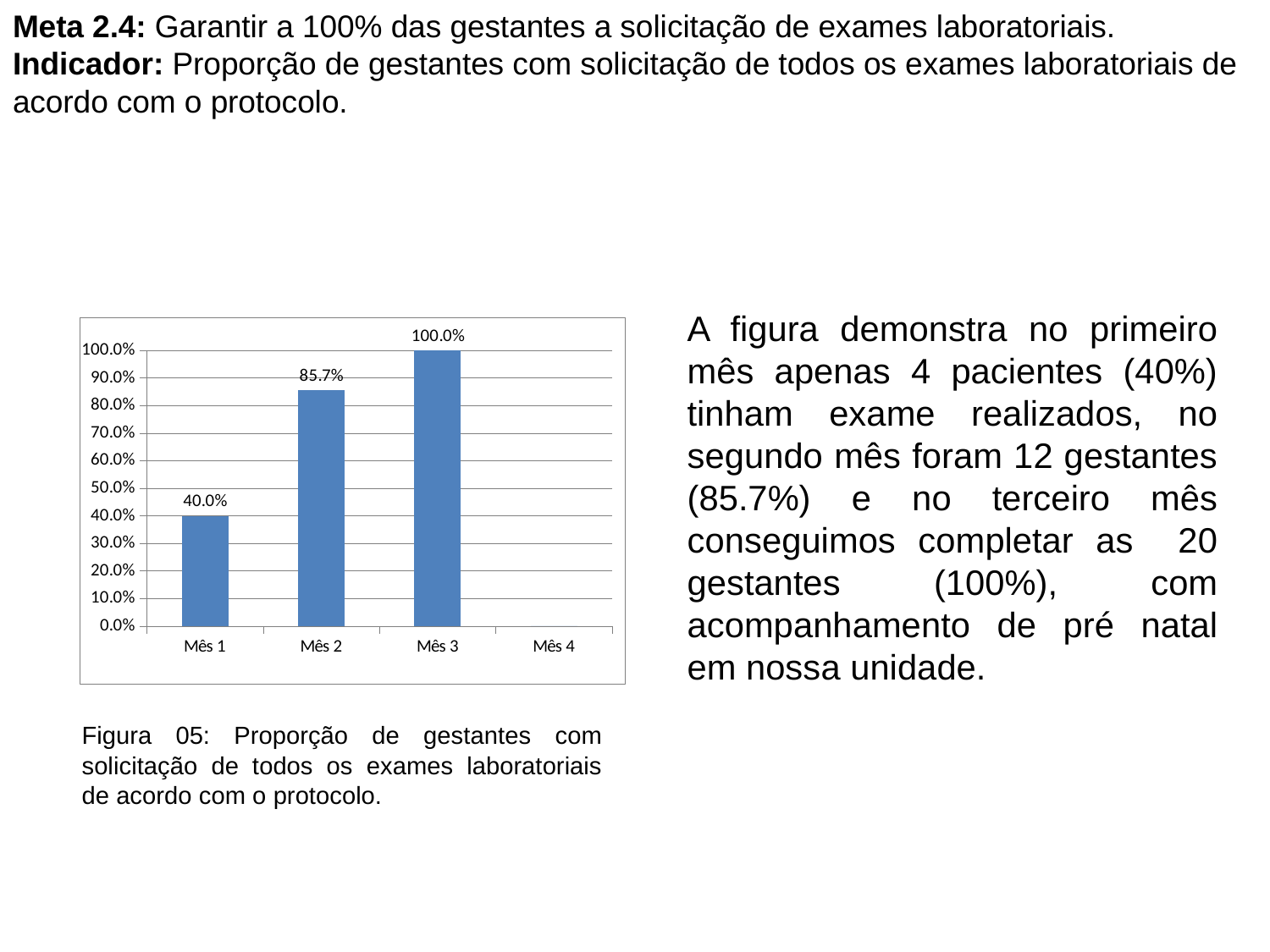
Which month has the highest value? Mês 3 What is the difference between the values for Mês 2 and Mês 1? 45.7% What is the value for Mês 2? 85.7% Do the values rise or fall from Mês 1 to Mês 3? rise What is the value for Mês 1? 40.0% What is the value for Mês 3? 100.0% What kind of chart is shown on the slide? bar chart Which is larger, the value for Mês 2 or the value for Mês 1? Mês 2 How many month categories are shown on the x axis? 4 What is the difference between the values for Mês 3 and Mês 1? 60.0% Is the value for Mês 2 greater or less than 80.0%? greater Which month with a plotted bar has the lowest value? Mês 1